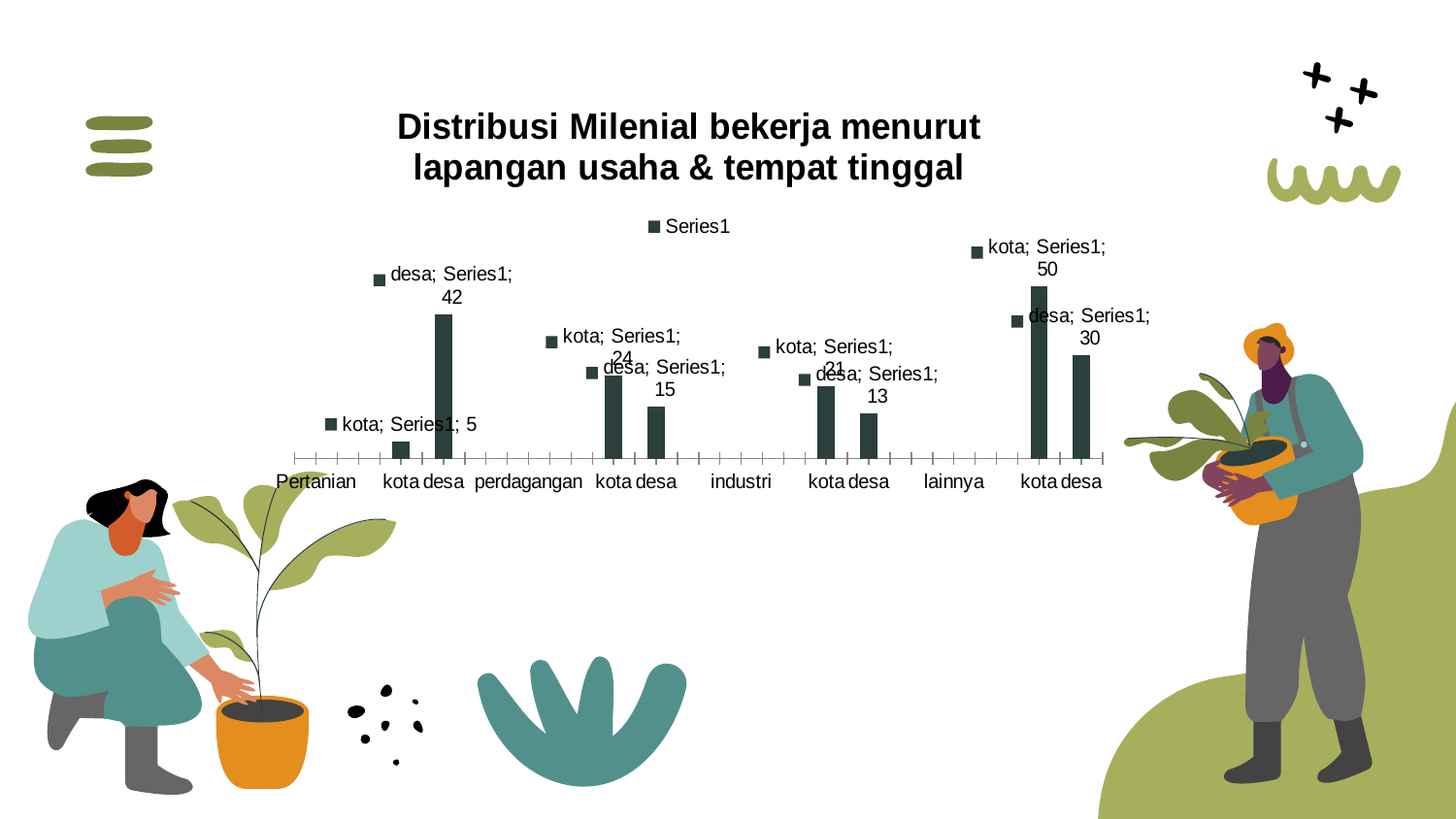
What is the title of the chart? Distribusi Milenial bekerja menurut lapangan usaha & tempat tinggal Which bar has the lowest value in the chart? kota in Pertanian What is the value for desa in Pertanian? 42 How many series does the legend list? 1 Which is larger in perdagangan, the kota value or the desa value? kota What is the value for kota in Pertanian? 5 What kind of chart is shown on the slide? bar chart Which bar has the highest value in the chart? kota in lainnya What is the value for kota in lainnya? 50 What is the difference between the kota and desa values in lainnya? 20 What is the value for desa in industri? 13 What is the value for kota in perdagangan? 24